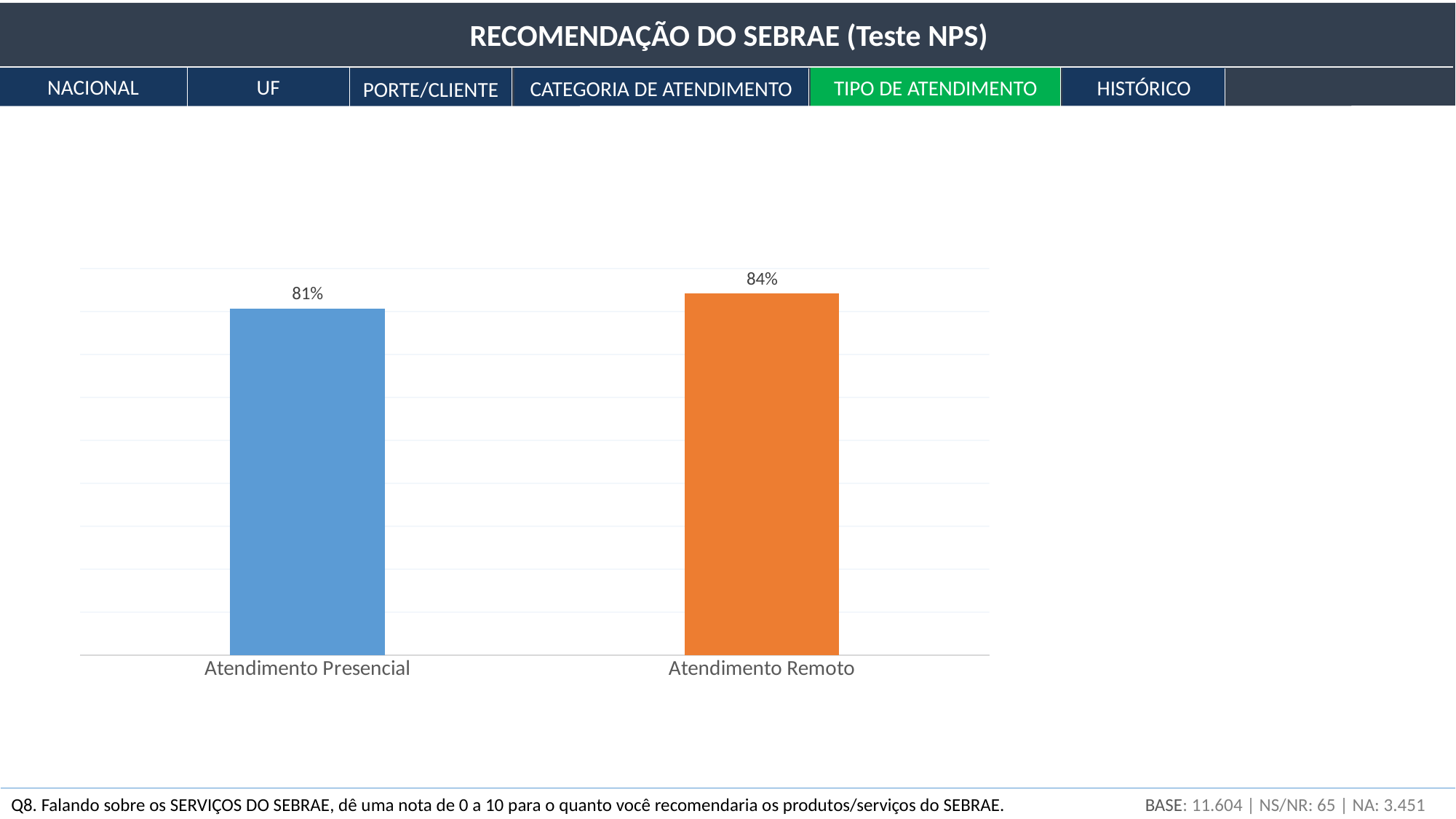
What is the difference between the values for Atendimento Remoto and Atendimento Presencial? 3% Which category has the lowest value? Atendimento Presencial Do the values rise or fall from Atendimento Presencial to Atendimento Remoto? Rise Which category has the highest value? Atendimento Remoto What colour is the bar for Atendimento Remoto? Orange How many categories are shown in the chart? 2 What is the value for Atendimento Remoto? 84% What is the value for Atendimento Presencial? 81% What kind of chart is shown on the slide? Bar chart Which is larger, the value for Atendimento Presencial or the value for Atendimento Remoto? Atendimento Remoto What is the title shown at the top of the slide? RECOMENDAÇÃO DO SEBRAE (Teste NPS)